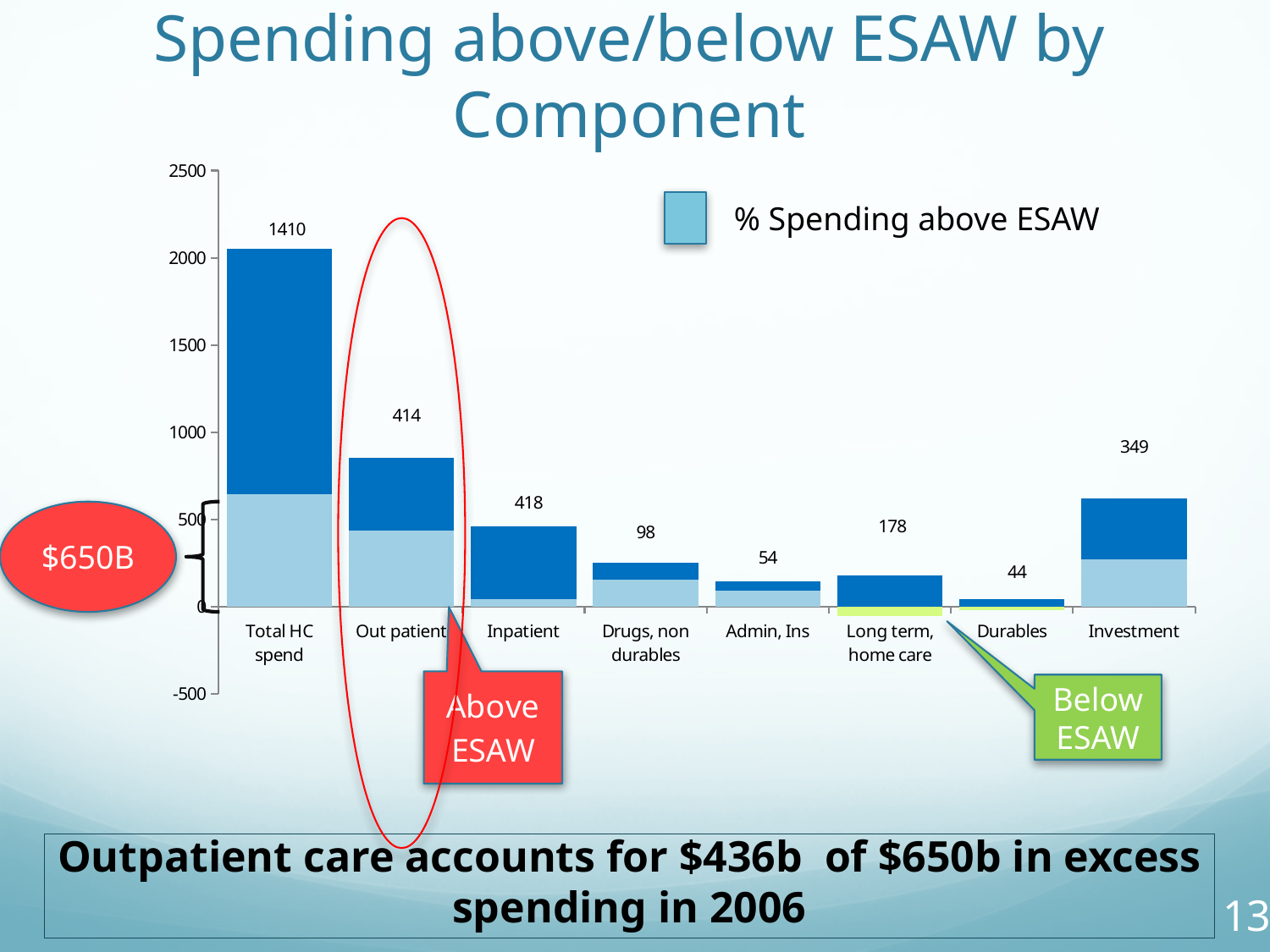
What kind of chart is shown on the slide? bar chart Which has the larger data label, Drugs, non durables or Admin, Ins? Drugs, non durables What is the legend entry shown on the chart? % Spending above ESAW What is the difference between the data labels for Investment and Long term, home care? 171 Which category has the lowest data label on the chart? Durables How many categories are shown along the x axis of the chart? 8 What is the data label shown above the Long term, home care bar? 178 What is the data label shown above the Out patient bar? 414 Which category has the highest data label on the chart? Total HC spend How many series does the chart's legend list? 1 What is the data label shown above the Investment bar? 349 What is the data label shown above the Total HC spend bar? 1410